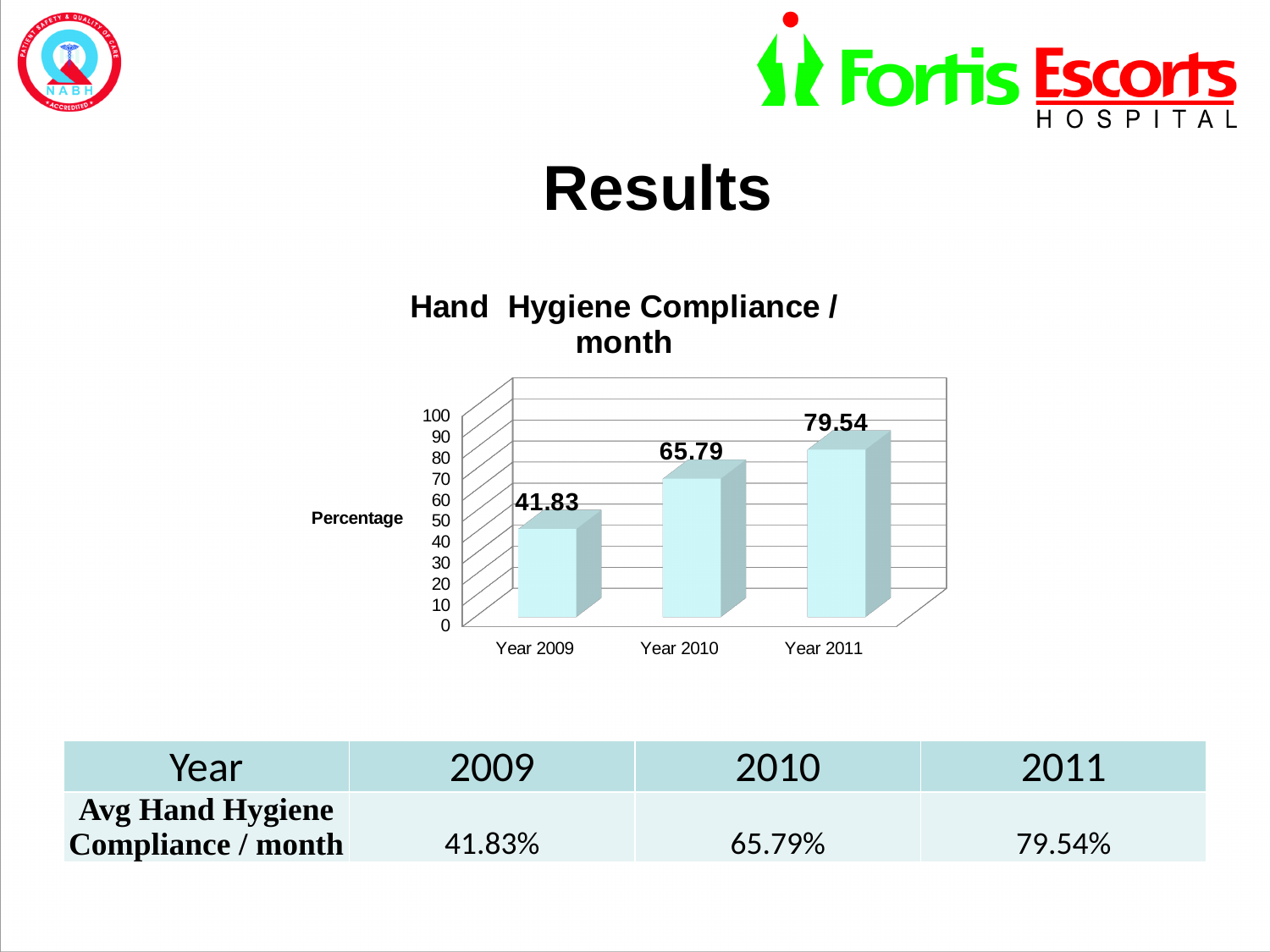
Which year has the lowest hand hygiene compliance in the chart? Year 2009 What kind of chart is shown on the slide? bar chart What is the value for Year 2011 in the Hand Hygiene Compliance / month chart? 79.54 What is the difference between the values for Year 2010 and Year 2009? 23.96 Which is larger, the value for Year 2010 or the value for Year 2011? Year 2011 How many years are shown on the x axis of the chart? 3 What is the difference between the values for Year 2011 and Year 2009? 37.71 What is the value for Year 2009 in the Hand Hygiene Compliance / month chart? 41.83 Do the values rise or fall from Year 2009 to Year 2011? rise Is the value for Year 2009 greater or less than 50? less What is the value for Year 2010 in the Hand Hygiene Compliance / month chart? 65.79 Which year has the highest hand hygiene compliance in the chart? Year 2011